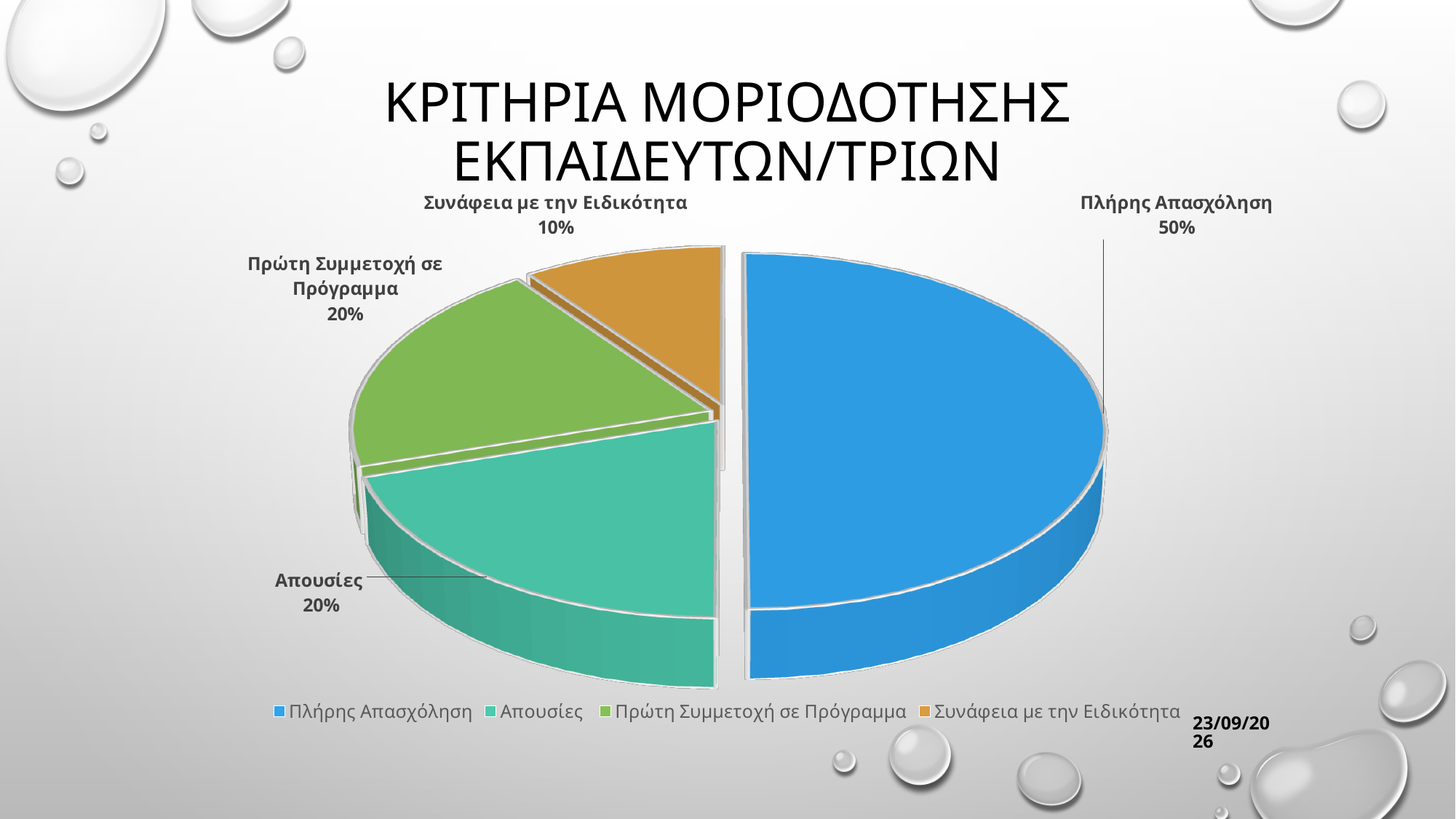
What colour is the slice for Συνάφεια με την Ειδικότητα? Orange Which category has the smallest slice of the pie? Συνάφεια με την Ειδικότητα What kind of chart is shown on the slide? Pie chart Which is larger, the share for Απουσίες or the share for Συνάφεια με την Ειδικότητα? Απουσίες What share of the pie does Συνάφεια με την Ειδικότητα represent? 10% What is the difference between the shares of Πρώτη Συμμετοχή σε Πρόγραμμα and Συνάφεια με την Ειδικότητα? 10% What share of the pie does Πλήρης Απασχόληση represent? 50% How many categories are shown in the pie chart? 4 What is the difference between the shares of Πλήρης Απασχόληση and Απουσίες? 30% Which category has the largest slice of the pie? Πλήρης Απασχόληση What is the value shown for Απουσίες? 20% What is the value shown for Πρώτη Συμμετοχή σε Πρόγραμμα? 20%